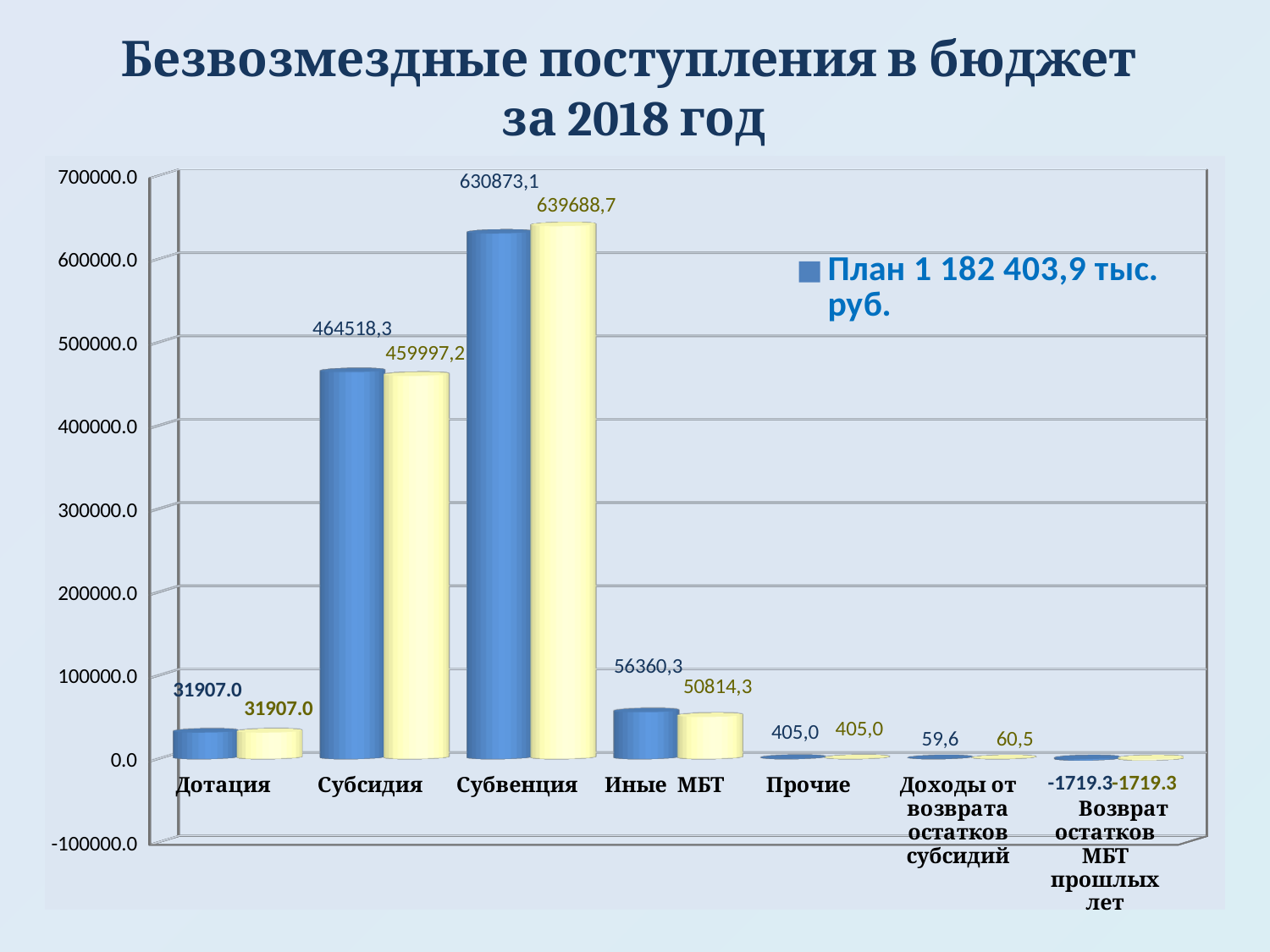
What is the value of the yellow bar for Субвенция? 639688,7 What is the value of the yellow bar for Иные МБТ? 50814,3 Which category has the highest blue (План) bar? Субвенция What is the value of the blue (План) bar for Субсидия? 464518,3 What is the difference between the blue and yellow bars for Иные МБТ? 5546,0 Which category has the lowest blue (План) bar? Возврат остатков МБТ прошлых лет What is the title of the slide? Безвозмездные поступления в бюджет за 2018 год How many categories are shown on the x axis of the chart? 7 What legend entry is shown on the chart? План 1 182 403,9 тыс. руб. For Субсидия, which is larger: the blue (План) bar or the yellow bar? The blue (План) bar What is the value of the blue (План) bar for Субвенция? 630873,1 What type of chart is shown on the slide? Bar chart